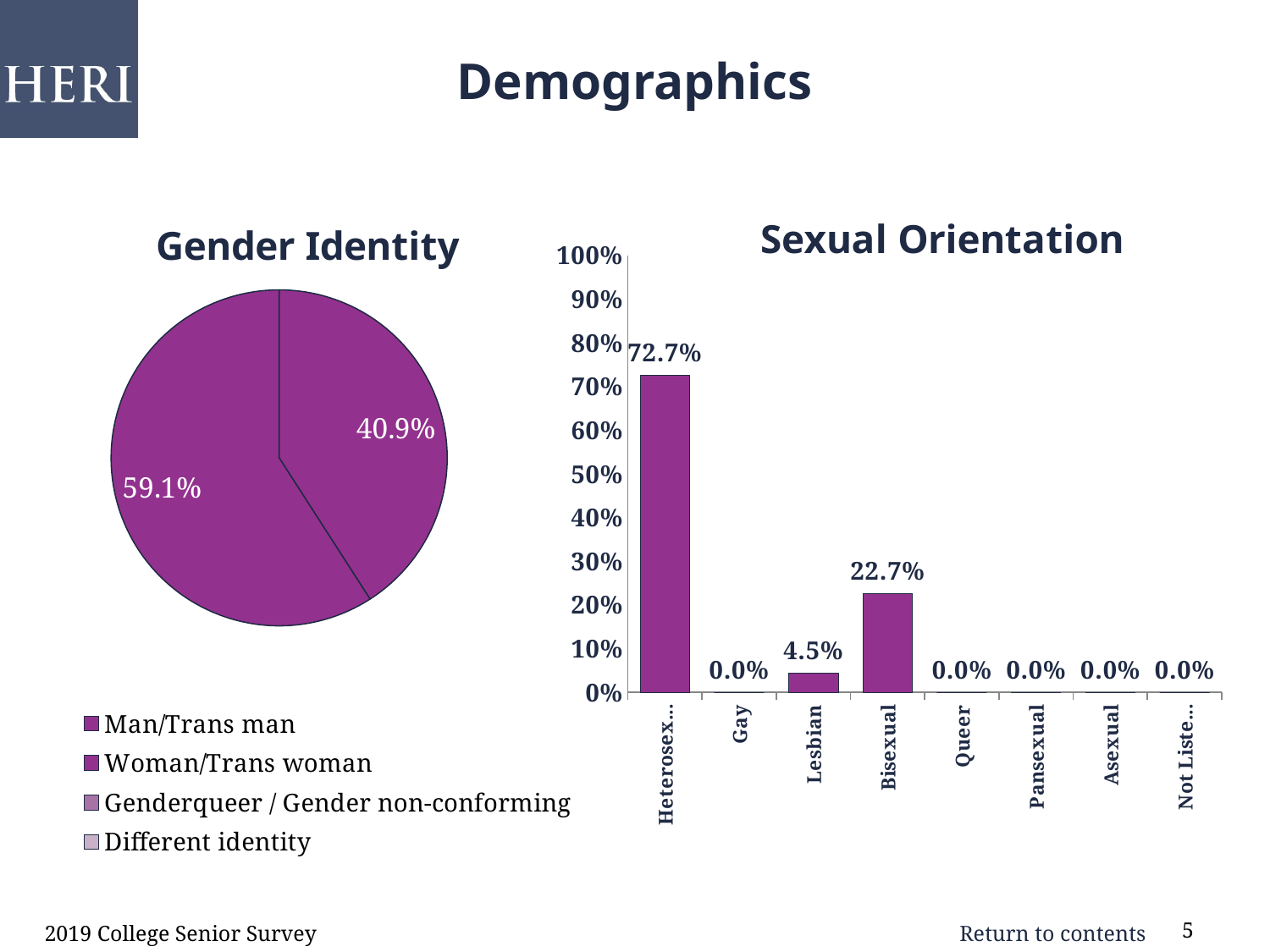
In the Sexual Orientation chart, what is the value for Bisexual? 22.7% In the Sexual Orientation chart, which category has the highest value? Heterosexual What kind of chart is the Gender Identity chart? pie chart In the Gender Identity pie chart, what is the value of the larger slice? 59.1% What kind of chart is the Sexual Orientation chart? bar chart In the Sexual Orientation chart, what is the difference between the Bisexual and Lesbian values? 18.2% In the Sexual Orientation chart, which is larger, Lesbian or Bisexual? Bisexual In the Sexual Orientation chart, what is the value for Gay? 0.0% In the Sexual Orientation chart, what is the value for Lesbian? 4.5% How many entries does the legend of the Gender Identity chart list? 4 In the Sexual Orientation chart, what is the difference between the Heterosexual and Bisexual values? 50.0% How many categories are shown on the x axis of the Sexual Orientation chart? 8